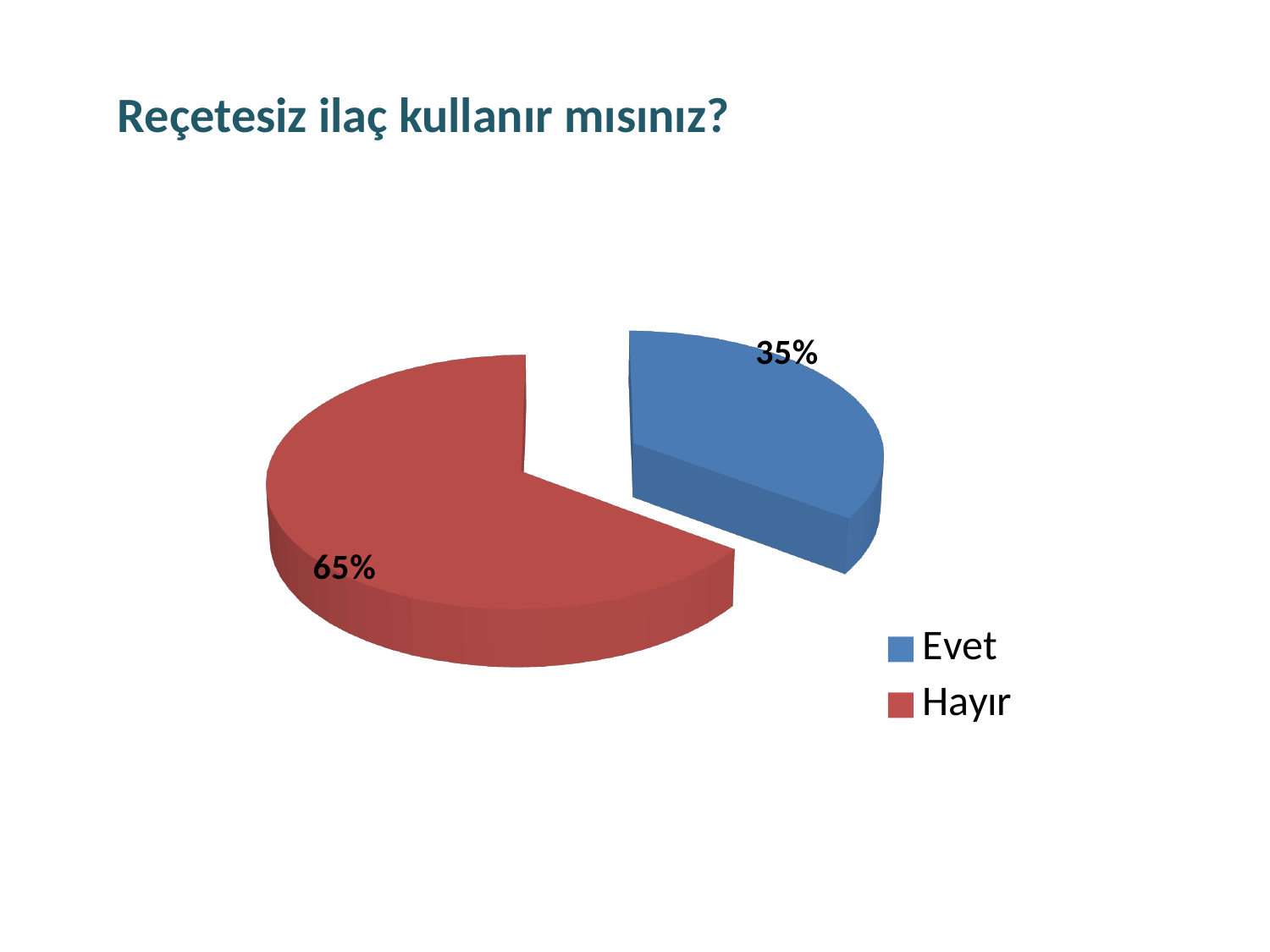
What share of the pie does Evet have? 35% How many entries does the legend list? 2 What kind of chart is shown on the slide? Pie chart Which is larger, the Evet slice or the Hayır slice? Hayır What is the title of the slide above the chart? Reçetesiz ilaç kullanır mısınız? Which category has the largest slice of the pie? Hayır How many slices does the pie chart have? 2 What colour is the Hayır slice? Red What share of the pie does Hayır have? 65% Which category has the smallest slice of the pie? Evet What is the difference in percentage points between Hayır and Evet? 30